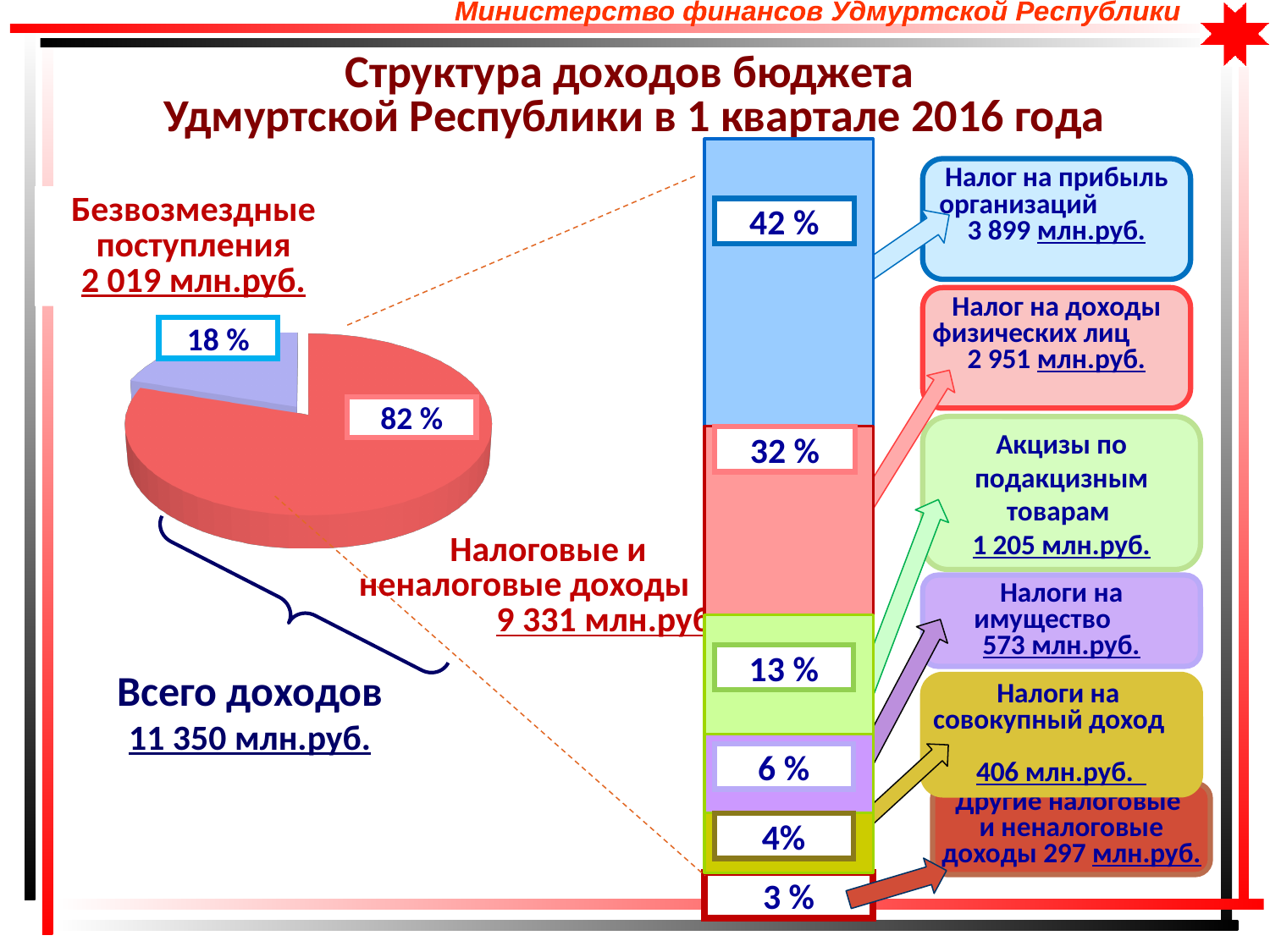
In the stacked bar on the right, which segment has the largest share? Налог на прибыль организаций In the stacked bar on the right, which segment has the smallest share? Другие налоговые и неналоговые доходы How many segments does the stacked bar on the right contain? 6 In the stacked bar on the right, what is the difference in percentage points between 'Налог на прибыль организаций' and 'Налог на доходы физических лиц'? 10 What amount in млн.руб. is shown for 'Налоги на совокупный доход'? 406 млн.руб. How many slices does the pie chart have? 2 In the stacked bar on the right, which is larger: 'Акцизы по подакцизным товарам' or 'Налоги на имущество'? Акцизы по подакцизным товарам In the pie chart, what is the value shown for 'Безвозмездные поступления'? 2 019 млн.руб. In the pie chart, what share of total revenues is 'Налоговые и неналоговые доходы'? 82 % What is the total revenue ('Всего доходов') shown on the slide? 11 350 млн.руб. What kind of chart is shown on the left side of the slide? pie chart In the stacked bar on the right, what percentage is shown for 'Налог на прибыль организаций'? 42 %